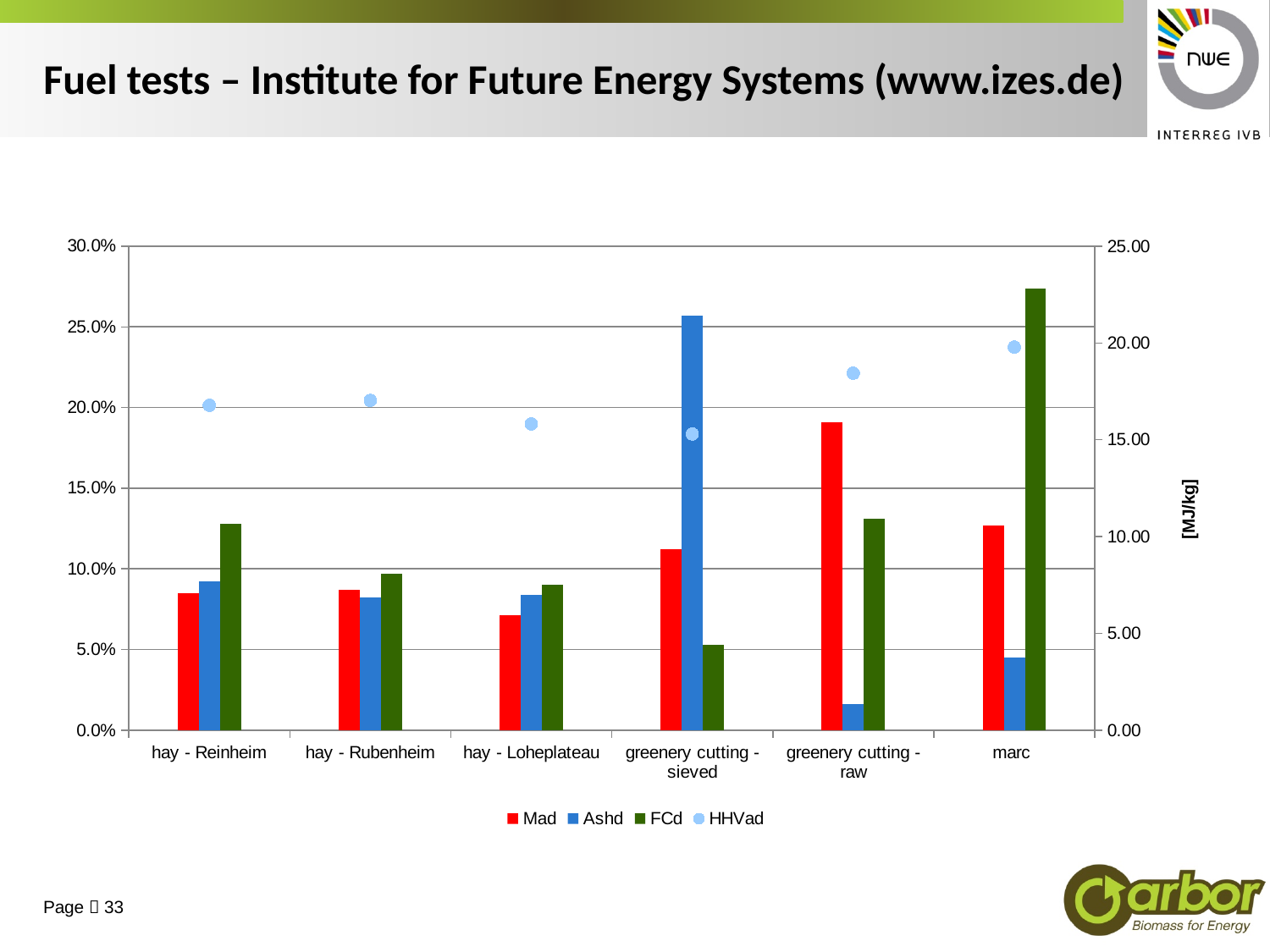
What kind of chart is shown on the slide? bar chart Which category has the lowest Ashd value? greenery cutting - raw Which category has the highest Mad value? greenery cutting - raw What unit label is shown on the right-hand axis? [MJ/kg] Is the Ashd value for greenery cutting - sieved greater or less than 20.0%? greater For greenery cutting - raw, which is larger: the Mad value or the FCd value? Mad Which category has the highest Ashd value? greenery cutting - sieved Which category has the lowest Mad value? hay - Loheplateau Which category has the highest FCd value? marc How many series does the legend list? 4 Is the FCd value for marc greater or less than 25.0%? greater How many fuel categories are shown on the x axis? 6